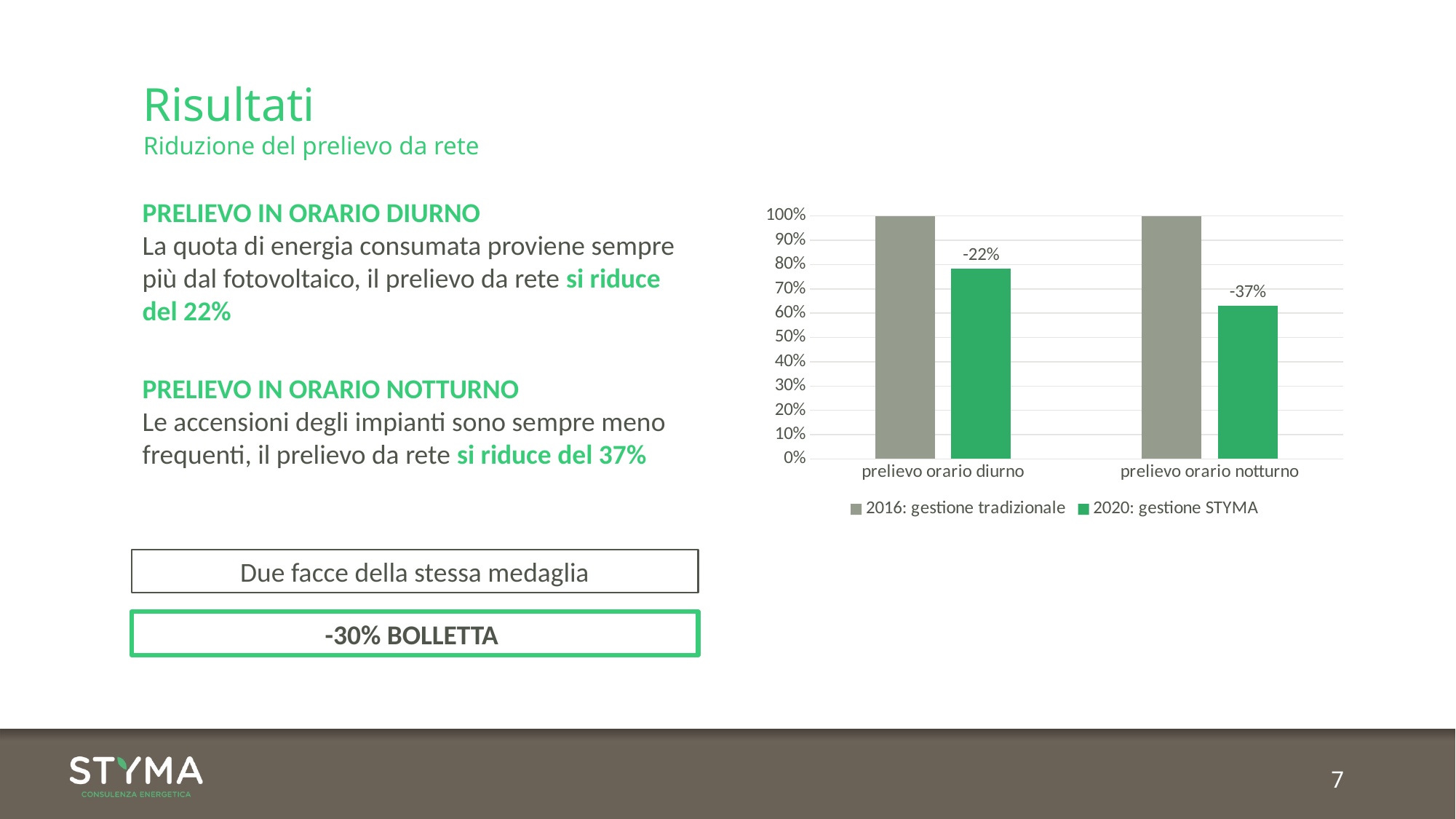
What is the value of the 2016: gestione tradizionale bar for prelievo orario diurno? 100% What is the value of the 2016: gestione tradizionale bar for prelievo orario notturno? 100% How many categories are shown on the x axis of the chart? 2 What kind of chart is shown on the slide? bar chart What data label is printed above the 2020: gestione STYMA bar for prelievo orario notturno? -37% How many series does the chart legend list? 2 What colour are the 2020: gestione STYMA bars in the chart? green Is the 2020: gestione STYMA value for prelievo orario notturno greater or less than 70%? less Which 2020: gestione STYMA bar is larger, prelievo orario diurno or prelievo orario notturno? prelievo orario diurno What data label is printed above the 2020: gestione STYMA bar for prelievo orario diurno? -22% Is the 2020: gestione STYMA value for prelievo orario diurno greater or less than 70%? greater Which bar in the chart is the lowest? 2020: gestione STYMA for prelievo orario notturno